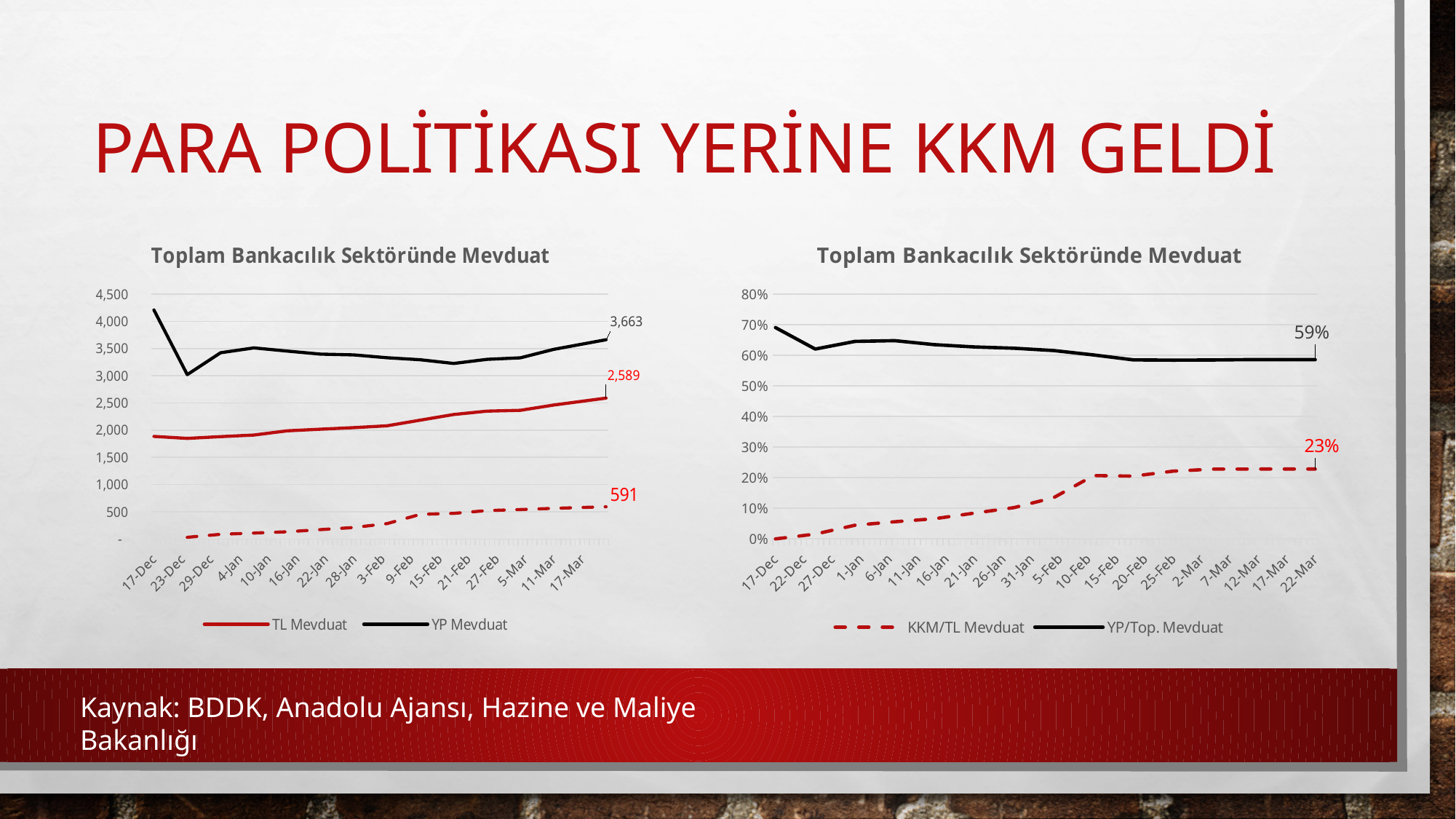
On the right chart, does the KKM/TL Mevduat line rise or fall over the period shown? Rise On the left chart, what is the labelled final value of the TL Mevduat line? 2,589 What kind of chart is the left chart? Line chart On the right chart, what is the labelled final value of the KKM/TL Mevduat line? 23% On the left chart, which series is higher at the end of the period, TL Mevduat or YP Mevduat? YP Mevduat On the left chart, what is the labelled final value of the YP Mevduat line? 3,663 On the left chart, does the TL Mevduat line generally rise or fall from 17-Dec to 17-Mar? Rise How many series does the legend of the left chart list? 2 On the right chart, what is the labelled final value of the YP/Top. Mevduat line? 59% On the left chart, what is the difference between the final labelled values of YP Mevduat (3,663) and TL Mevduat (2,589)? 1,074 On the left chart, is the value of YP Mevduat at 17-Dec greater or less than 4,000? greater On the right chart, is the value of YP/Top. Mevduat at 17-Dec greater or less than 60%? greater